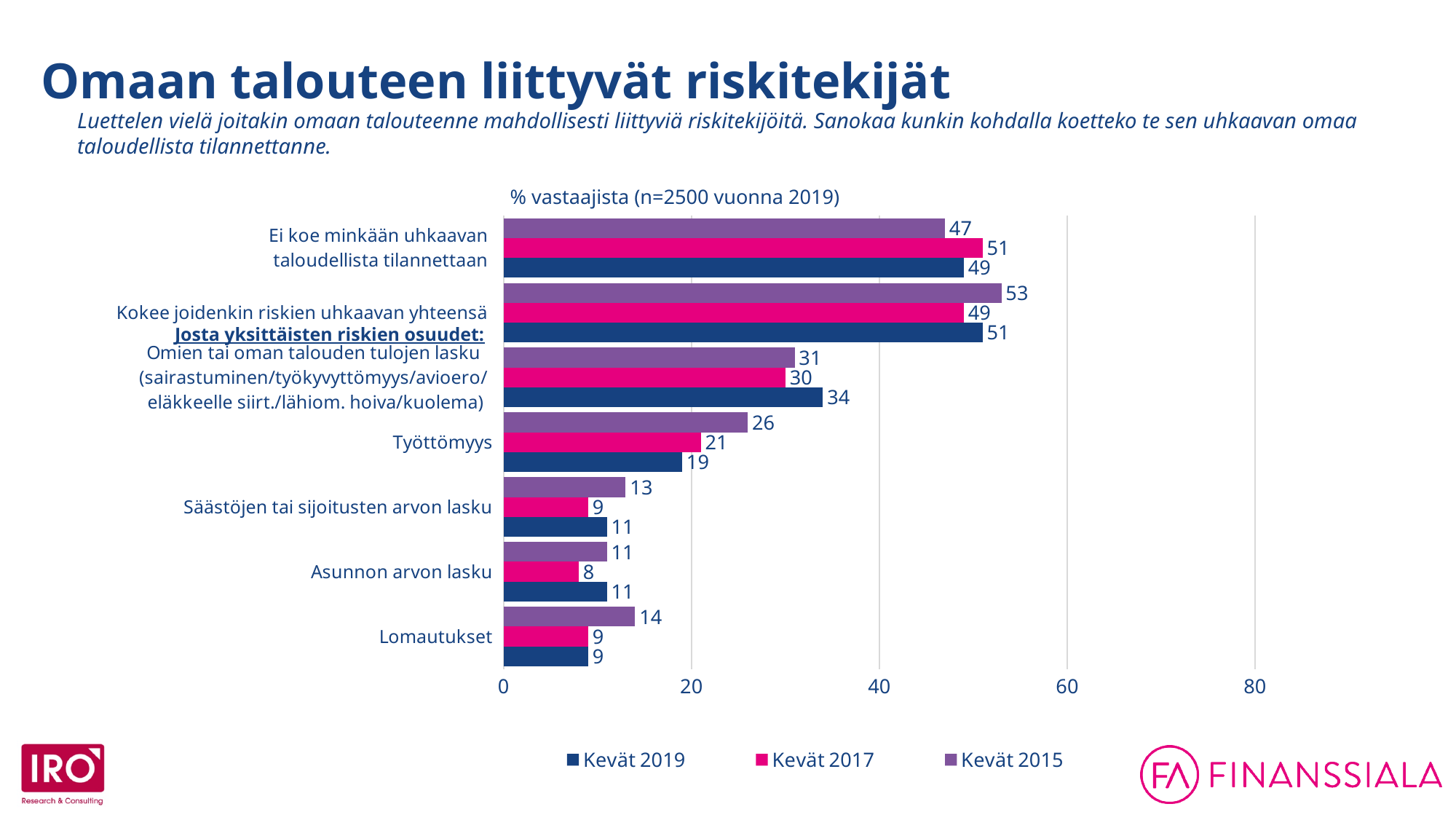
How many series does the legend list? 3 What is the Kevät 2019 value for Omien tai oman talouden tulojen lasku? 34 What kind of chart is shown on the slide? Bar chart What is the Kevät 2017 value for Asunnon arvon lasku? 8 What is the difference between the Kevät 2015 and Kevät 2019 values for Työttömyys? 7 Which category has the lowest Kevät 2017 value? Asunnon arvon lasku For Lomautukset, which is larger: the Kevät 2015 value or the Kevät 2017 value? Kevät 2015 How many categories are shown on the chart? 7 Which series is shown in pink in the legend? Kevät 2017 What is the Kevät 2015 value for Kokee joidenkin riskien uhkaavan yhteensä? 53 Which category has the highest Kevät 2015 value? Kokee joidenkin riskien uhkaavan yhteensä What is the Kevät 2019 value for Työttömyys? 19